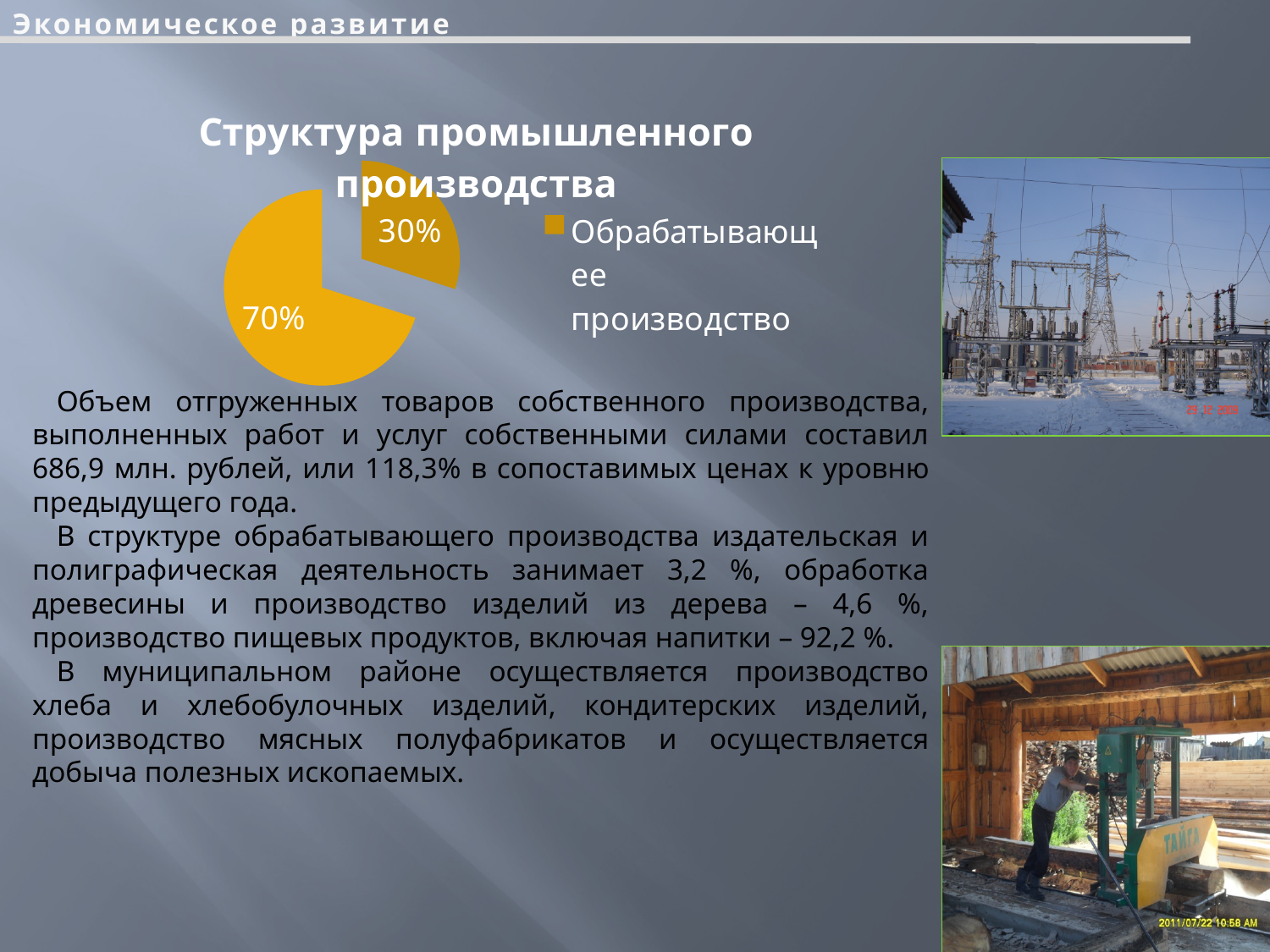
What do the two slices of the pie chart add up to? 100% What kind of chart is shown under the title "Структура промышленного производства"? pie chart Which slice of the pie chart is pulled out (exploded) from the rest? 30% How many entries does the legend of the pie chart list? 1 What is the title of the pie chart? Структура промышленного производства How many slices does the pie chart "Структура промышленного производства" have? 2 What is the difference between the two slices of the pie chart, in percentage points? 40 What is the value of the largest slice in the pie chart? 70% What is the legend entry shown next to the pie chart? Обрабатывающее производство Is the larger slice of the pie chart greater or less than 50%? greater Is the smaller slice of the pie chart greater or less than 50%? less What is the value of the smallest slice in the pie chart? 30%